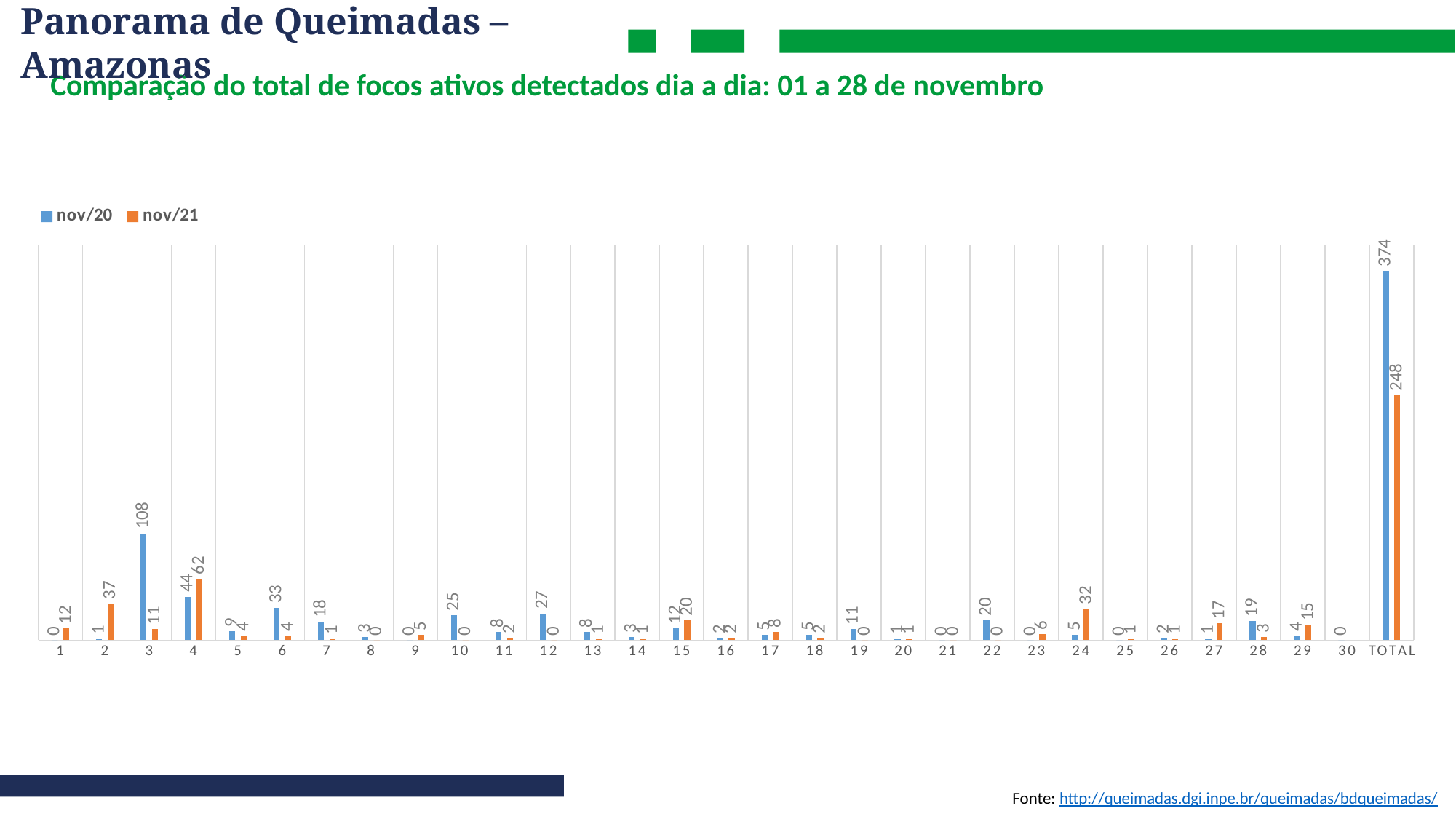
How many series does the legend list? 2 On day 15, which series has the larger value, nov/20 or nov/21? nov/21 What is the difference between the TOTAL values for nov/20 and nov/21? 126 Which colour represents the nov/21 series? Orange What is the value for nov/21 on day 24? 32 What is the value for nov/21 on day 4? 62 Excluding the TOTAL bar, on which day is the nov/20 value highest? 3 Excluding the TOTAL bar, on which day is the nov/21 value highest? 4 What kind of chart is shown on the slide? Bar chart What is the difference between the nov/20 and nov/21 values on day 3? 97 What is the value for nov/20 on day 3? 108 What is the TOTAL value for nov/21? 248